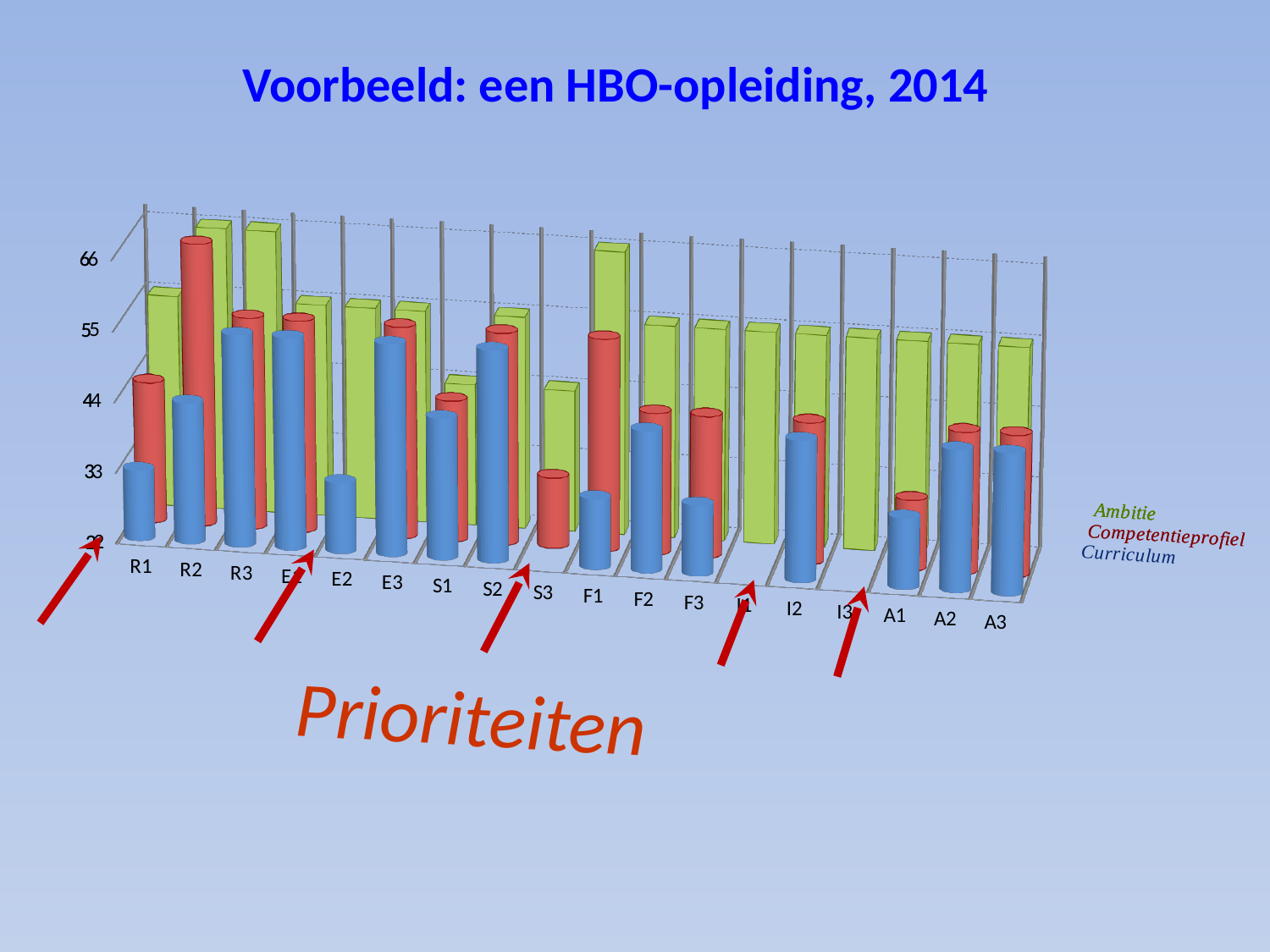
Which series is shown in green? Ambitie Is the Curriculum value for A1 greater or less than 44? less Which category has the highest Competentieprofiel value? R2 Is the Competentieprofiel value for R2 greater or less than 55? greater How many categories are shown on the x axis? 18 For F1, which is larger: the Ambitie value or the Curriculum value? Ambitie For R2, which is larger: the Competentieprofiel value or the Curriculum value? Competentieprofiel What is the title of the slide above the chart? Voorbeeld: een HBO-opleiding, 2014 Is the Ambitie value for F1 greater or less than 55? greater How many series does the legend list? 3 What kind of chart is shown on the slide? bar chart